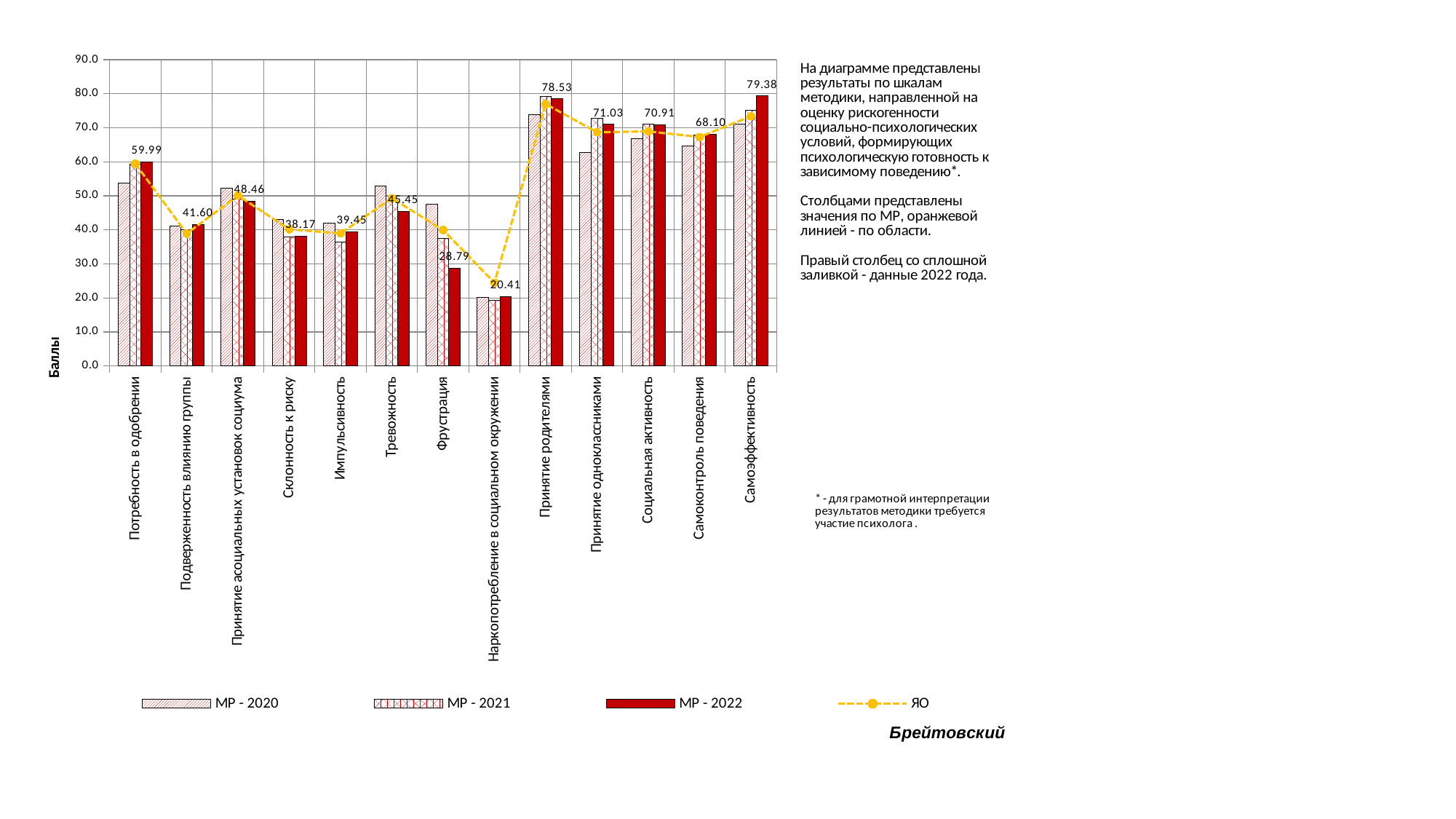
Is the МР - 2022 value for Принятие родителями greater or less than 70.0? greater Is the МР - 2022 value for Фрустрация greater or less than 30.0? less Which is larger, the ЯО value for Потребность в одобрении or for Тревожность? Потребность в одобрении How many categories are shown on the x axis? 13 What is the label of the vertical axis? Баллы Which category has the highest ЯО value? Принятие родителями How many series does the legend list? 4 Which category has the lowest ЯО value? Наркопотребление в социальном окружении